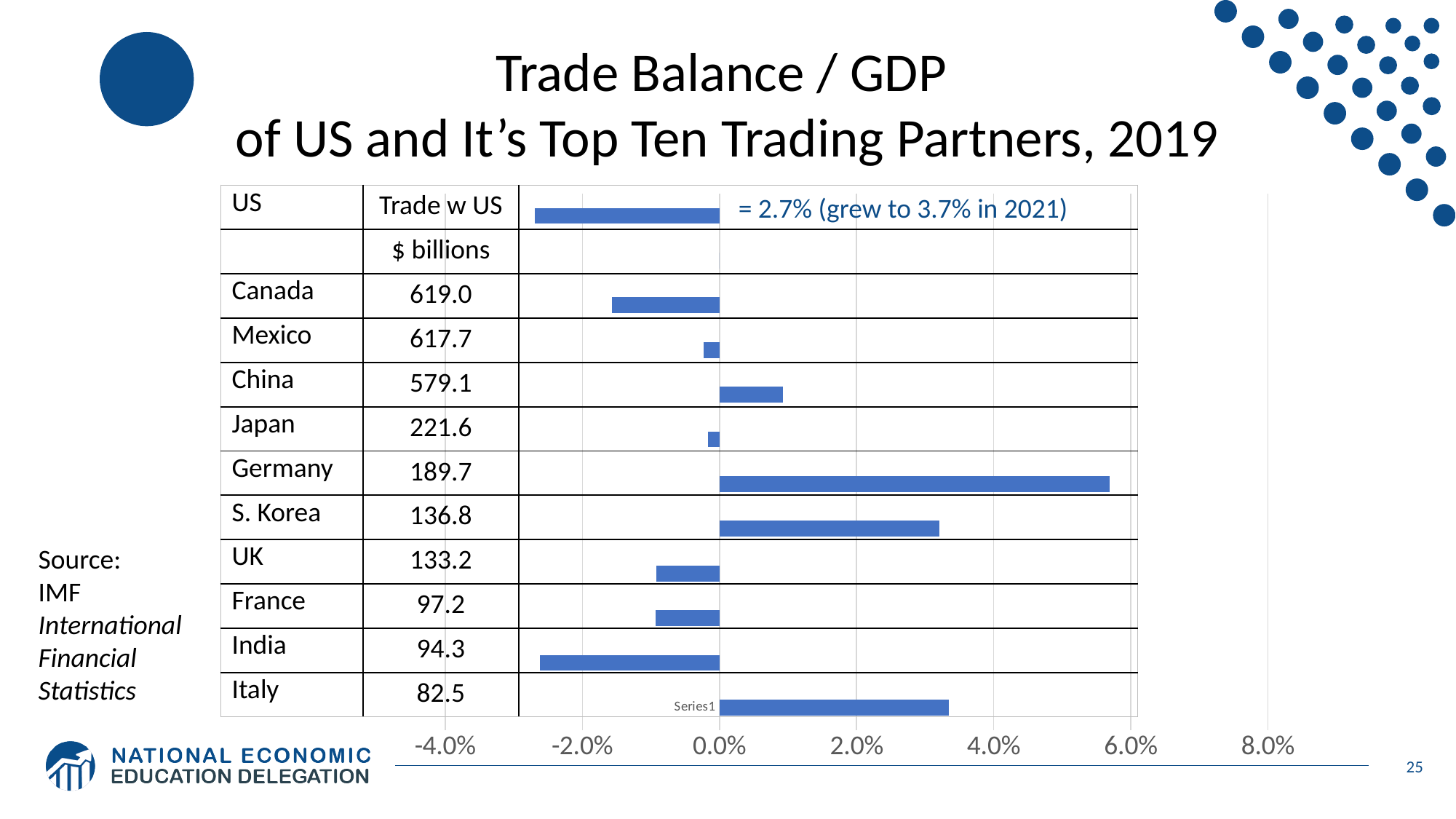
Is the value for Canada greater or less than 0.0%? less How many bars (countries including the US) are plotted on the chart? 11 Is the value for S. Korea greater or less than 2.0%? greater Is the value for China greater or less than 0.0%? greater Which country has the highest trade balance / GDP bar on the chart? Germany What kind of chart is shown on the slide? bar chart Which is larger, the value for China or the value for Canada? China Which is larger, the value for Germany or the value for S. Korea? Germany What is the highest value shown on the chart's horizontal axis? 8.0%